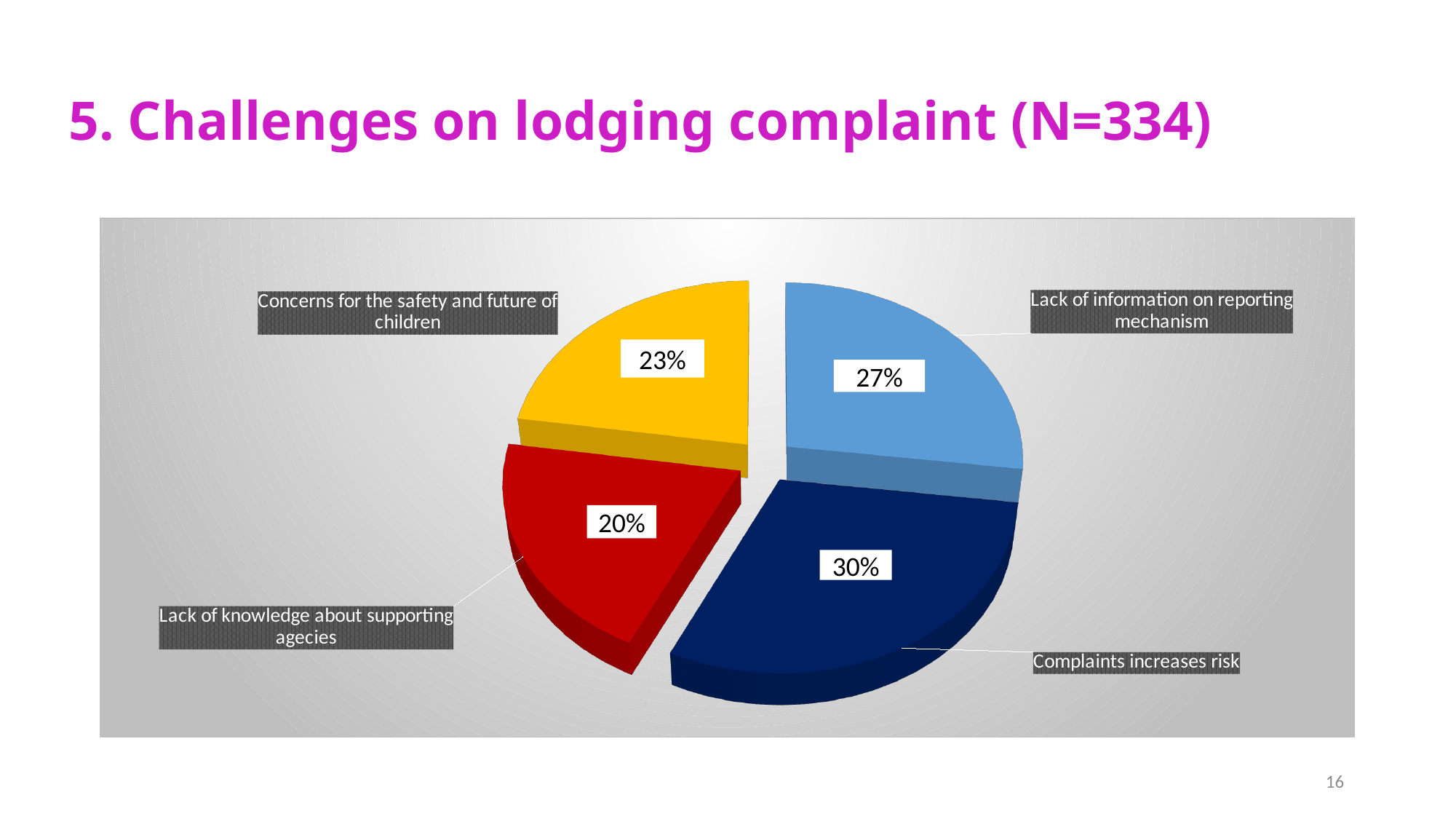
What is the difference in percentage points between 'Complaints increases risk' and 'Lack of knowledge about supporting agecies'? 10 percentage points What kind of chart is shown on the slide? Pie chart What share of the pie is 'Lack of knowledge about supporting agecies'? 20% What is the title of the slide containing the chart? 5. Challenges on lodging complaint (N=334) What share of the pie is 'Concerns for the safety and future of children'? 23% What share of the pie is 'Complaints increases risk'? 30% How many categories are shown in the pie chart? 4 Which category has the smallest slice of the pie? Lack of knowledge about supporting agecies What is the difference in percentage points between 'Lack of information on reporting mechanism' and 'Concerns for the safety and future of children'? 4 percentage points Which is larger: the slice for 'Lack of information on reporting mechanism' or the slice for 'Concerns for the safety and future of children'? Lack of information on reporting mechanism Which category has the largest slice of the pie? Complaints increases risk